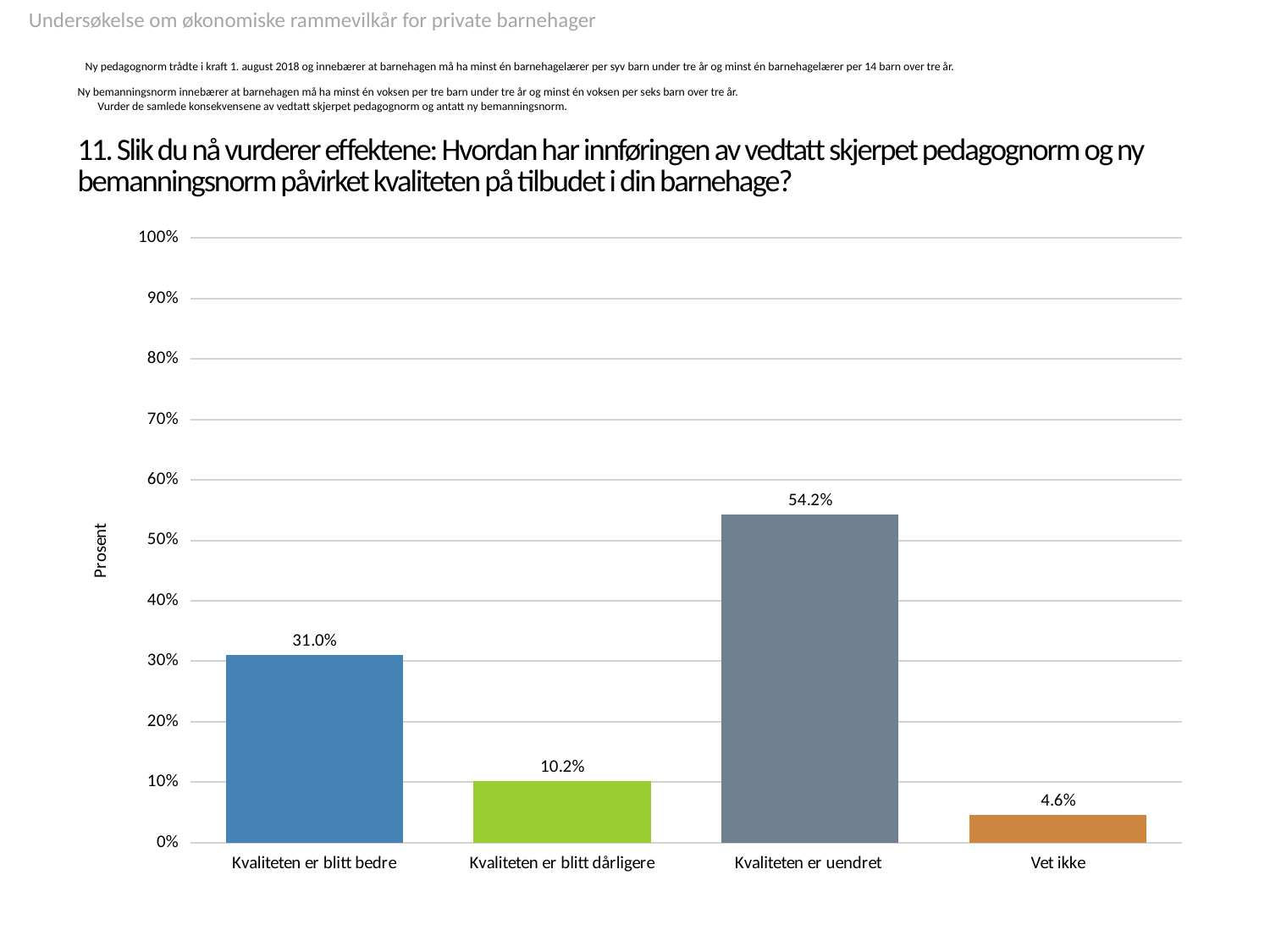
Which category has the highest value? Kvaliteten er uendret What is the value for "Kvaliteten er blitt bedre"? 31.0% What is the value for "Kvaliteten er blitt dårligere"? 10.2% What is the label of the y axis? Prosent Which is larger, "Kvaliteten er blitt bedre" or "Kvaliteten er blitt dårligere"? Kvaliteten er blitt bedre What is the difference between "Kvaliteten er uendret" and "Kvaliteten er blitt bedre"? 23.2% What kind of chart is shown on the slide? bar chart How many categories are shown on the x axis? 4 What is the value for "Vet ikke"? 4.6% Is the value for "Kvaliteten er uendret" greater or less than 50%? greater Which category has the lowest value? Vet ikke What is the value for "Kvaliteten er uendret"? 54.2%